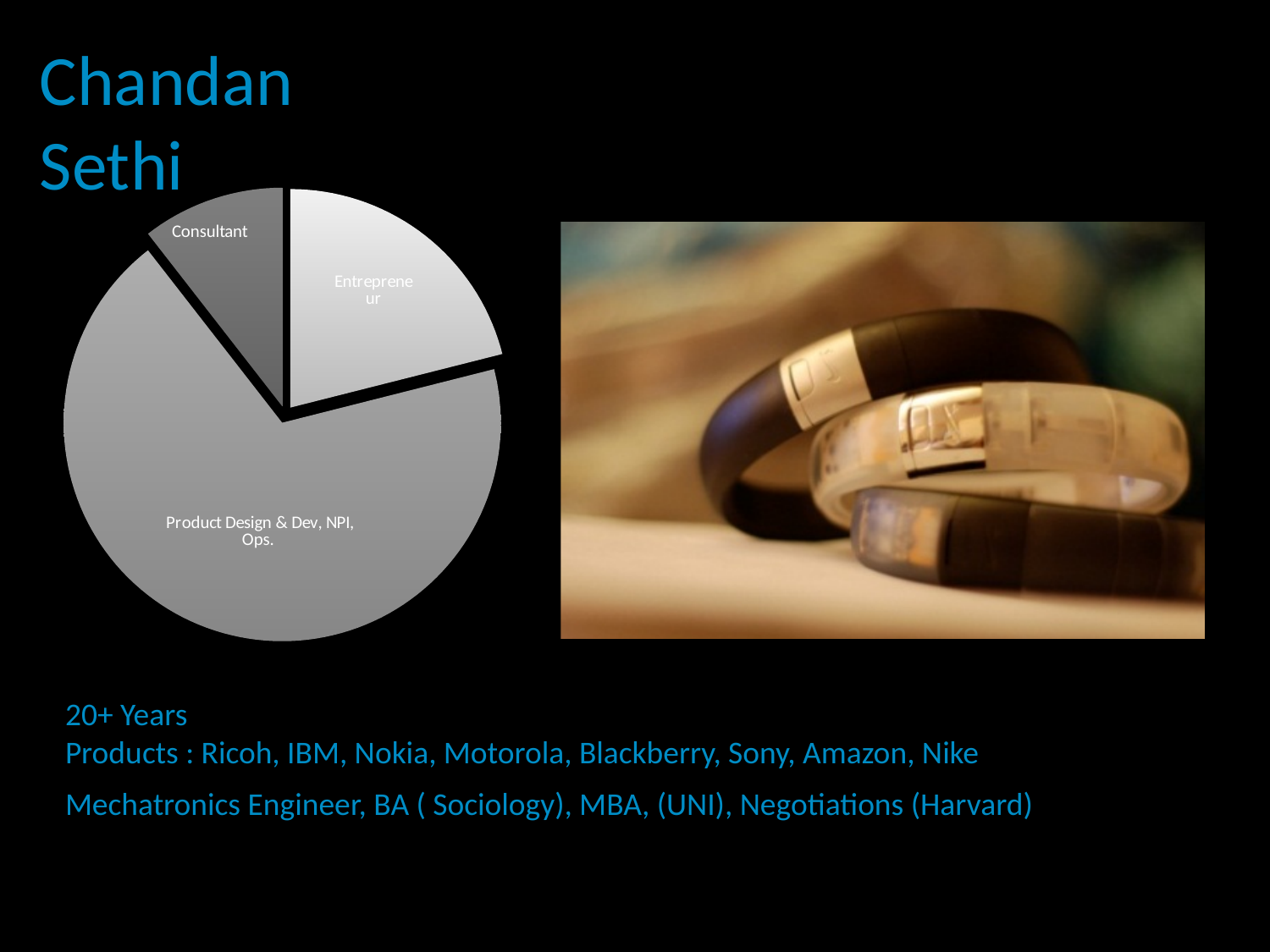
Which slice is larger in the pie chart, Entrepreneur or Consultant? Entrepreneur Does the Product Design & Dev, NPI, Ops. slice take up more or less than half of the pie chart? More Which slice of the pie chart is the largest? Product Design & Dev, NPI, Ops. What kind of chart is shown on the slide? Pie chart What are the labels of the three slices in the pie chart? Entrepreneur, Consultant, Product Design & Dev, NPI, Ops. Which slice of the pie chart is pulled out (exploded) from the rest of the pie? Entrepreneur Which slice is larger in the pie chart, Consultant or Product Design & Dev, NPI, Ops.? Product Design & Dev, NPI, Ops. Which slice is larger in the pie chart, Product Design & Dev, NPI, Ops. or Entrepreneur? Product Design & Dev, NPI, Ops. Which slice of the pie chart is the smallest? Consultant How many slices does the pie chart have? 3